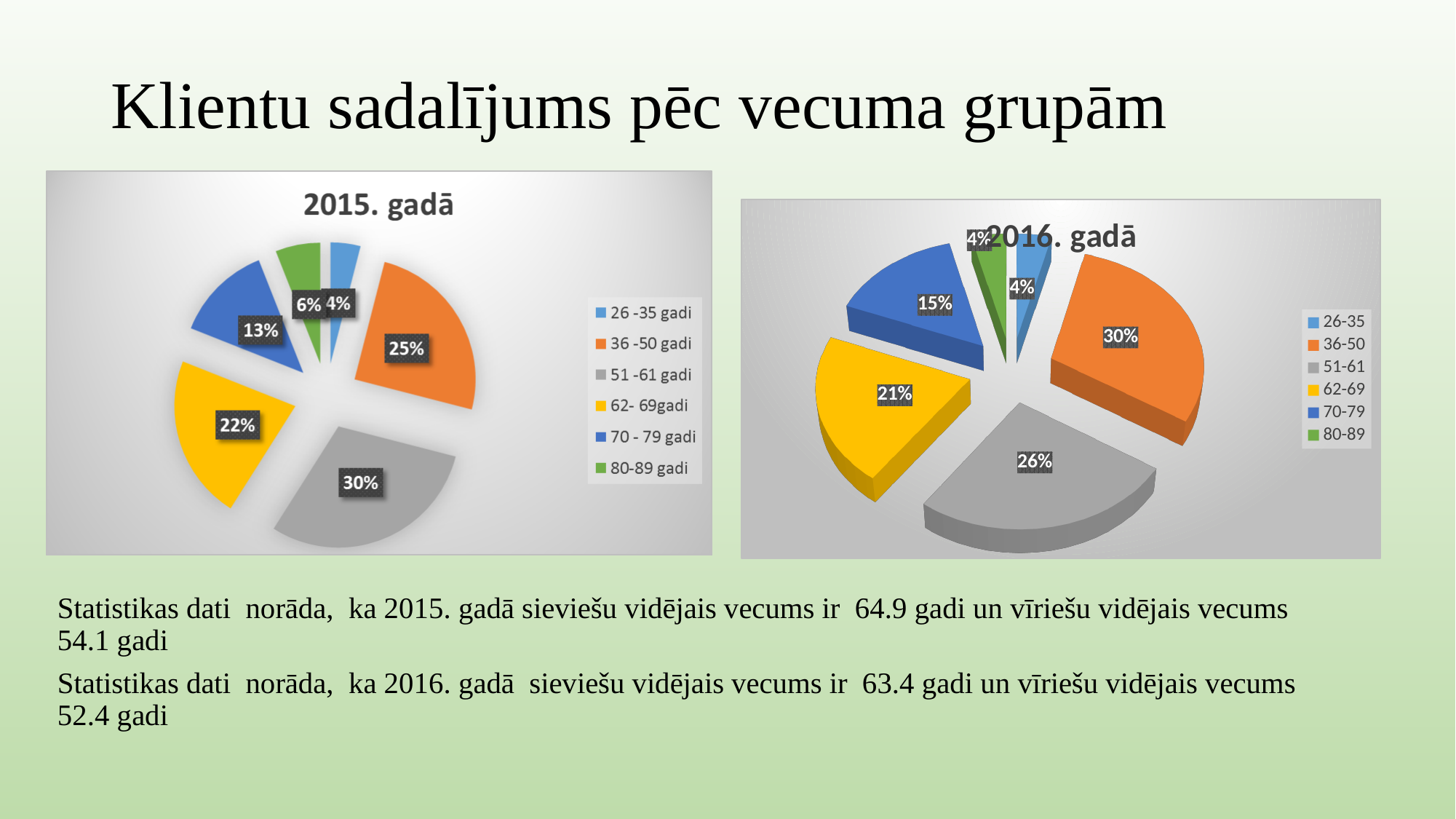
In the "2016. gadā" chart, which age group has the largest share? 36-50 In the "2016. gadā" chart, what share is shown for the 36-50 age group? 30% In the "2015. gadā" chart, which age group has the smallest share? 26 -35 gadi What type of chart is the "2015. gadā" chart? Pie chart How many age groups does the legend of the "2016. gadā" chart list? 6 In the "2015. gadā" chart, what is the difference between the shares of the 36-50 gadi and 80-89 gadi groups? 19 percentage points In the "2016. gadā" chart, which is larger: the share of the 51-61 group or the 70-79 group? 51-61 In the "2015. gadā" chart, what colour represents the 62- 69gadi group? Yellow In the "2015. gadā" chart, what share of clients is in the 51-61 gadi age group? 30% In the "2015. gadā" chart, which age group has the largest share? 51-61 gadi In the "2016. gadā" chart, what percentage is shown for the 62-69 age group? 21% In the "2015. gadā" chart, what percentage is shown for the 70-79 gadi group? 13%